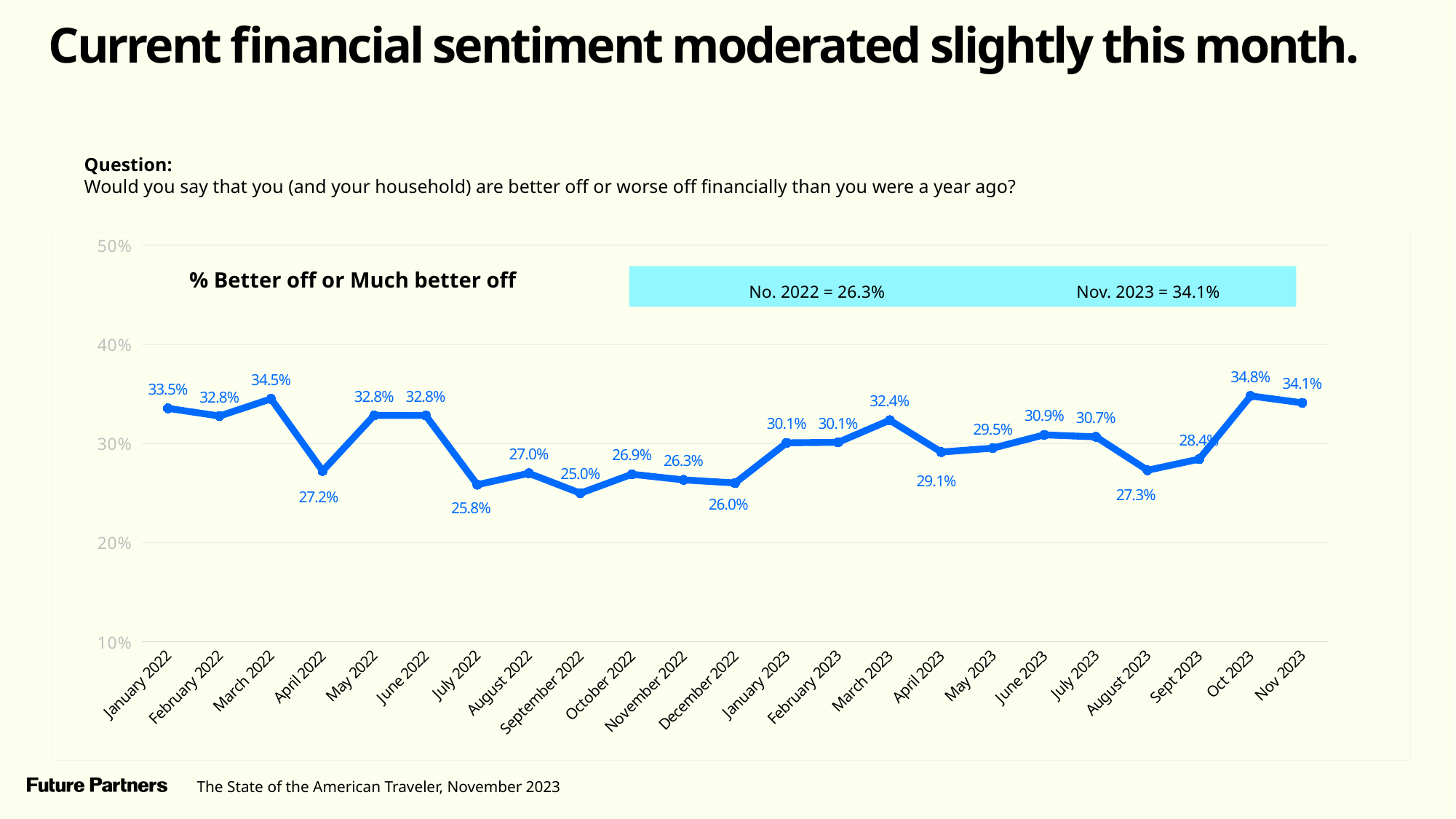
What kind of chart is shown on the slide? line chart What is the value for Nov 2023? 34.1% What is the difference between the Oct 2023 value and the Nov 2023 value? 0.7 percentage points How many months are plotted on the chart? 23 Is the value for August 2023 greater or less than 30%? less What is the difference between the Nov 2023 value and the November 2022 value? 7.8 percentage points What series label is shown on the chart? % Better off or Much better off What is the value for March 2023? 32.4% Which month has the highest value on the chart? Oct 2023 What is the value for September 2022? 25.0% Which month has the lowest value on the chart? September 2022 Which is larger, the value for March 2022 or the value for April 2022? March 2022